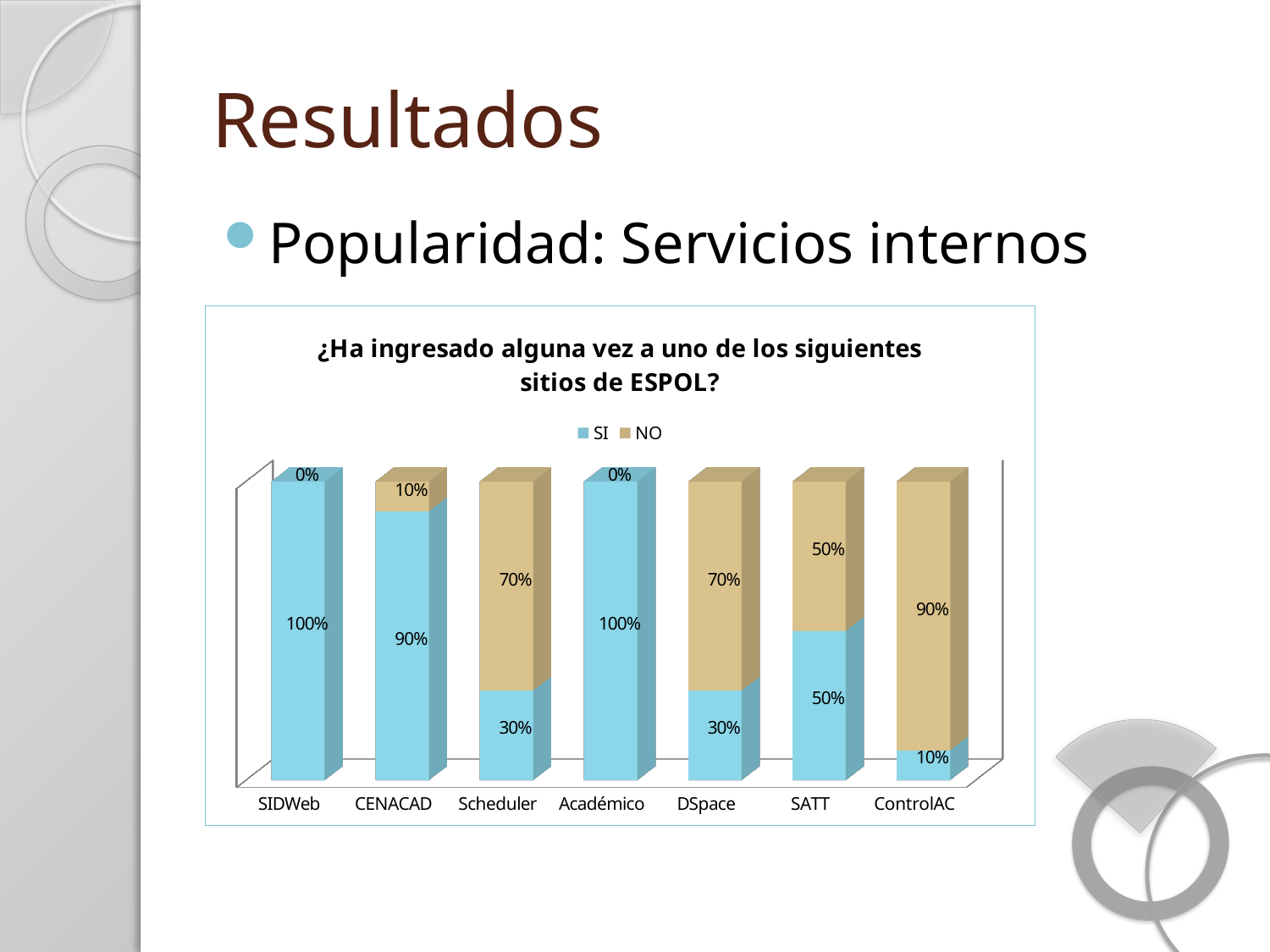
What is the title of the chart? ¿Ha ingresado alguna vez a uno de los siguientes sitios de ESPOL? What is the difference between the SI values for CENACAD and DSpace? 60% What is the SI value for CENACAD? 90% Which category has the lowest SI value? ControlAC What is the NO value for SATT? 50% Which is larger, the SI value for SATT or the SI value for Scheduler? SATT What kind of chart is shown? Stacked bar chart What is the NO value for Scheduler? 70% What is the SI value for ControlAC? 10% How many series does the legend list? 2 How many categories are shown on the x axis? 7 Which category has the highest NO value? ControlAC